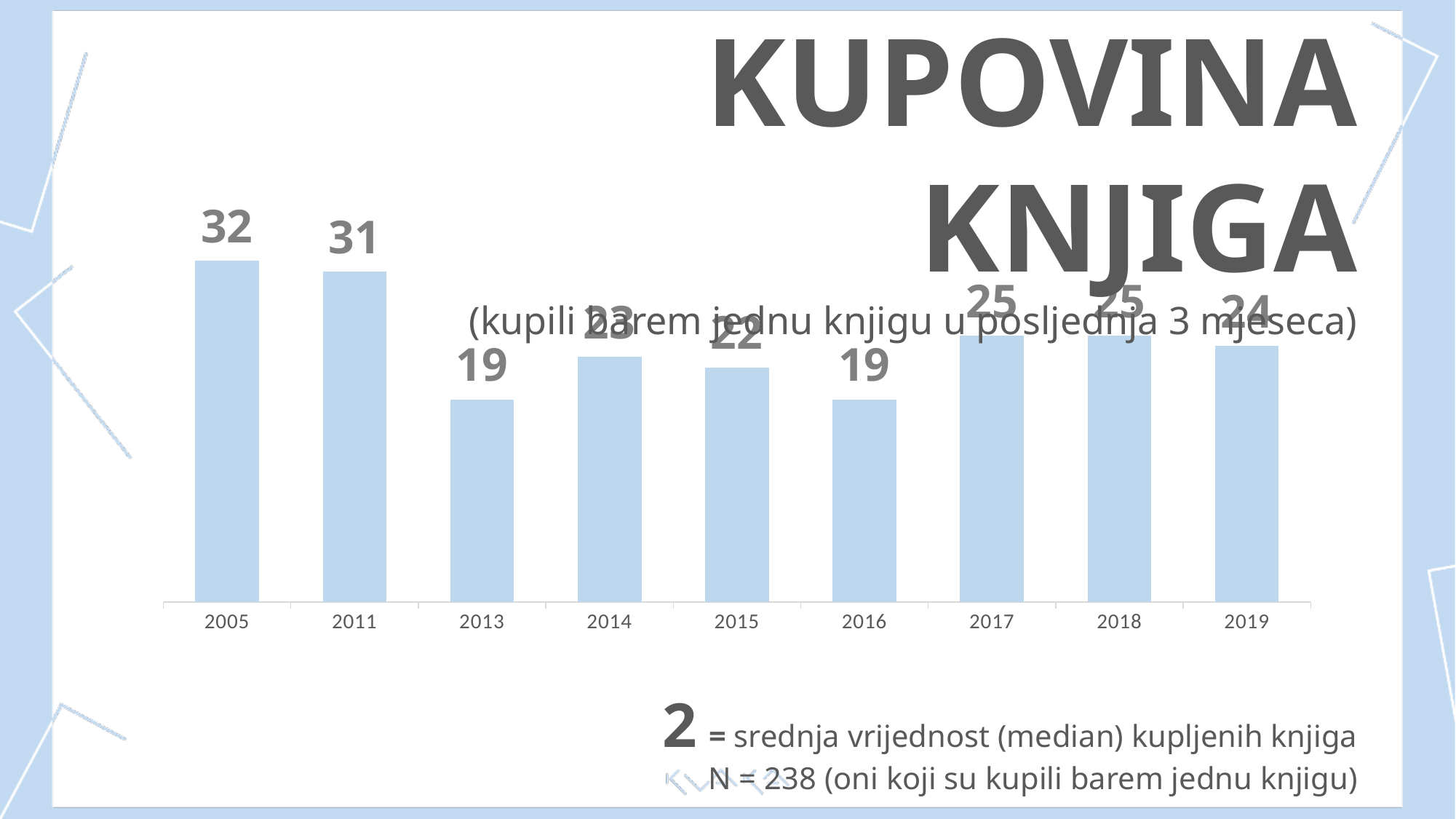
What value is shown for 2016? 19 Which is larger, the value for 2011 or the value for 2016? 2011 Do the values rise or fall from 2005 to 2013? fall What value is shown for 2013? 19 What value is shown for 2015? 22 What is the difference between the values for 2011 and 2015? 9 What kind of chart is shown on the slide? bar chart What value is shown for 2011? 31 What value is shown for 2005? 32 Which year has the highest value? 2005 How many years are shown on the x axis? 9 What is the difference between the values for 2005 and 2013? 13